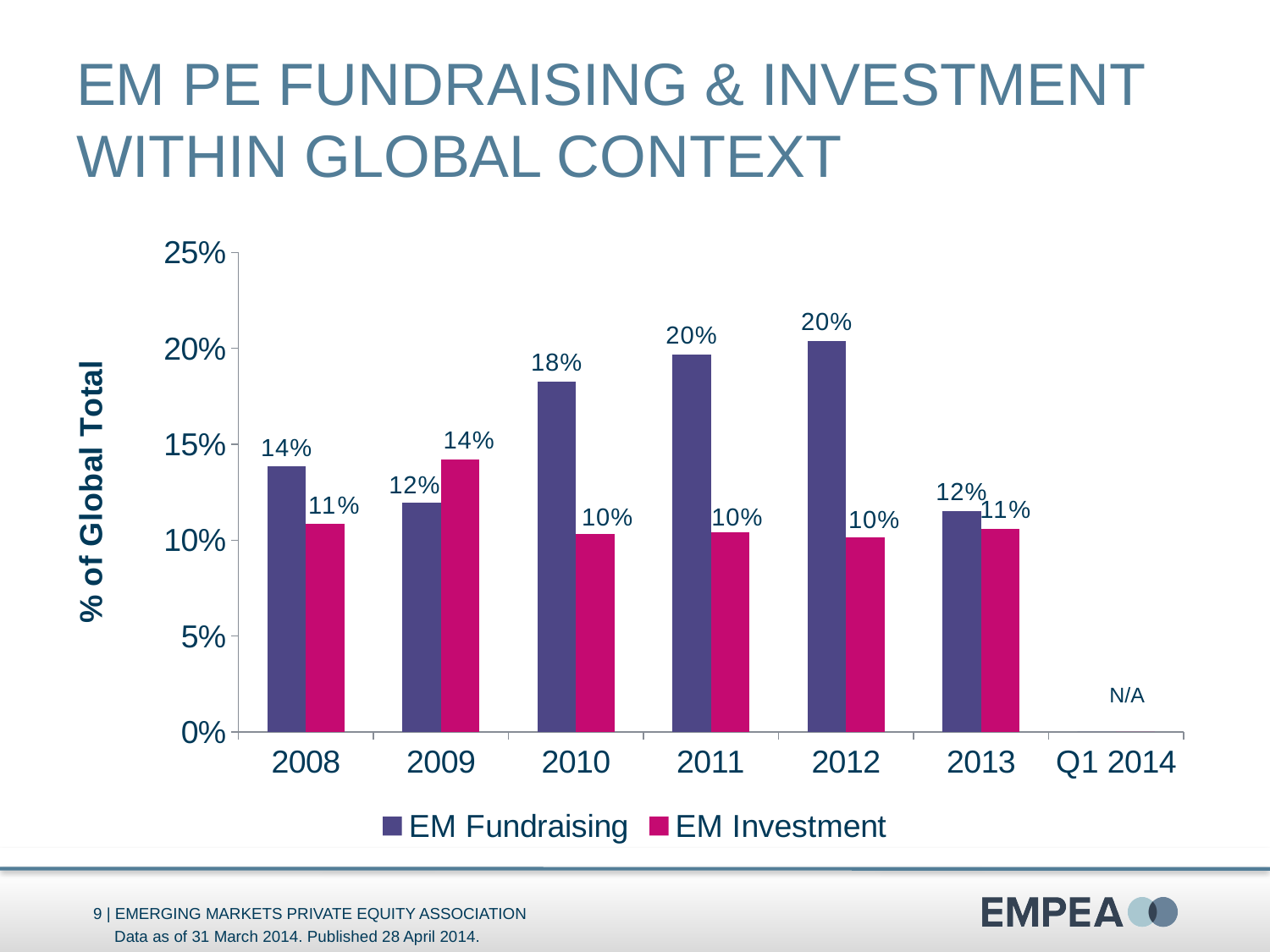
What kind of chart is shown on the slide? bar chart What is the EM Fundraising value for 2010? 18% Is the EM Fundraising value for 2011 greater or less than 15%? greater What is the difference between EM Fundraising and EM Investment in 2010? 8 percentage points How many series does the legend list? 2 In which year is EM Investment highest? 2009 What is the label of the y axis? % of Global Total In 2008, which is larger: EM Fundraising or EM Investment? EM Fundraising In 2009, which is larger: EM Fundraising or EM Investment? EM Investment How many time periods are shown on the x axis? 7 What is the EM Investment value for 2009? 14% What is the EM Fundraising value for 2013? 12%